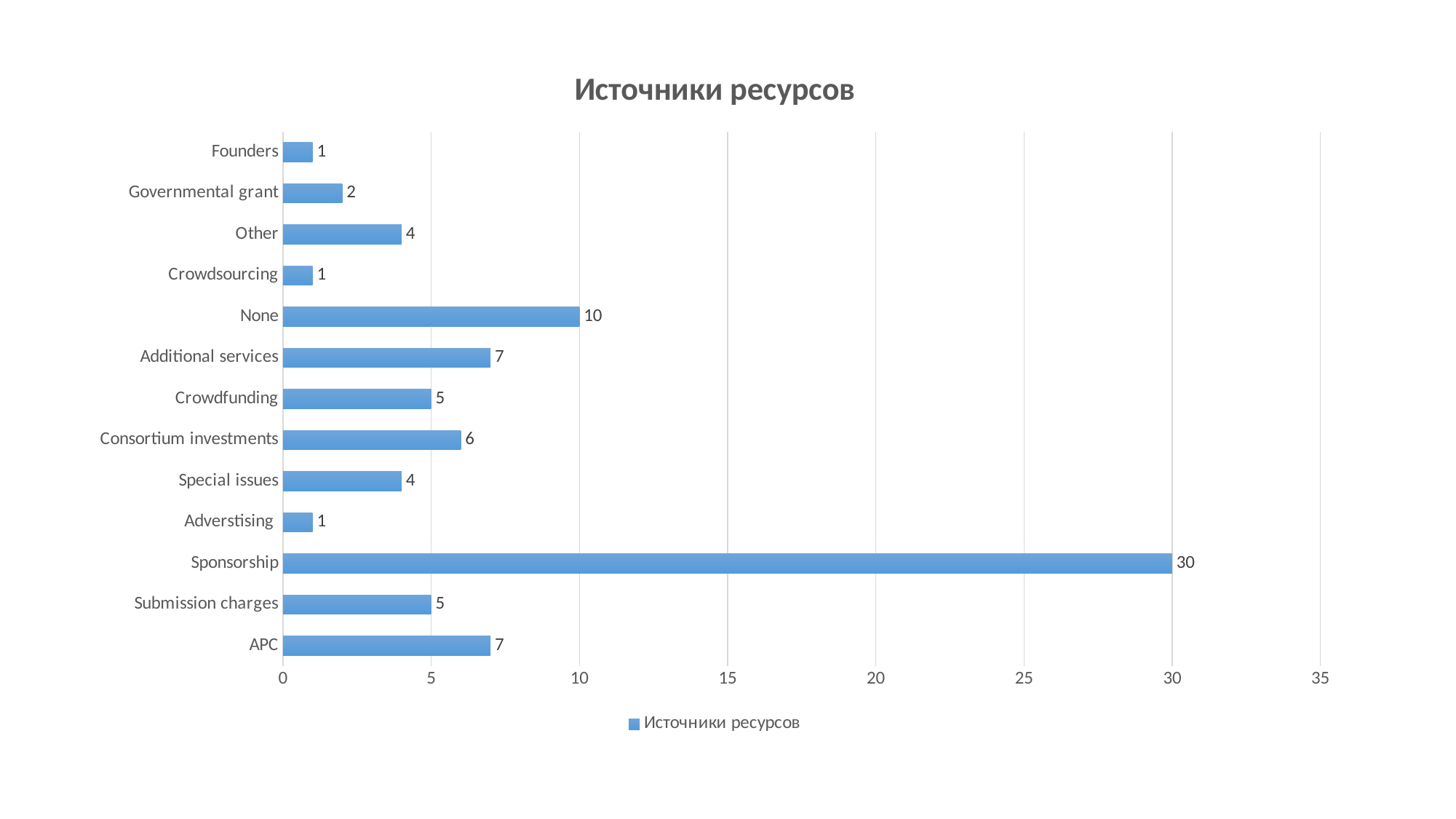
Which category has the highest value? Sponsorship How many series does the legend list? 1 What is the value for Sponsorship? 30 What kind of chart is shown on the slide? bar chart What is the difference between the values for Sponsorship and None? 20 Which is larger, the value for Consortium investments or the value for Crowdfunding? Consortium investments What is the value for Governmental grant? 2 How many categories are shown in the chart? 13 What is the title of the chart? Источники ресурсов Is the value for Additional services greater or less than 5? greater What is the value for None? 10 What is the difference between the values for APC and Submission charges? 2